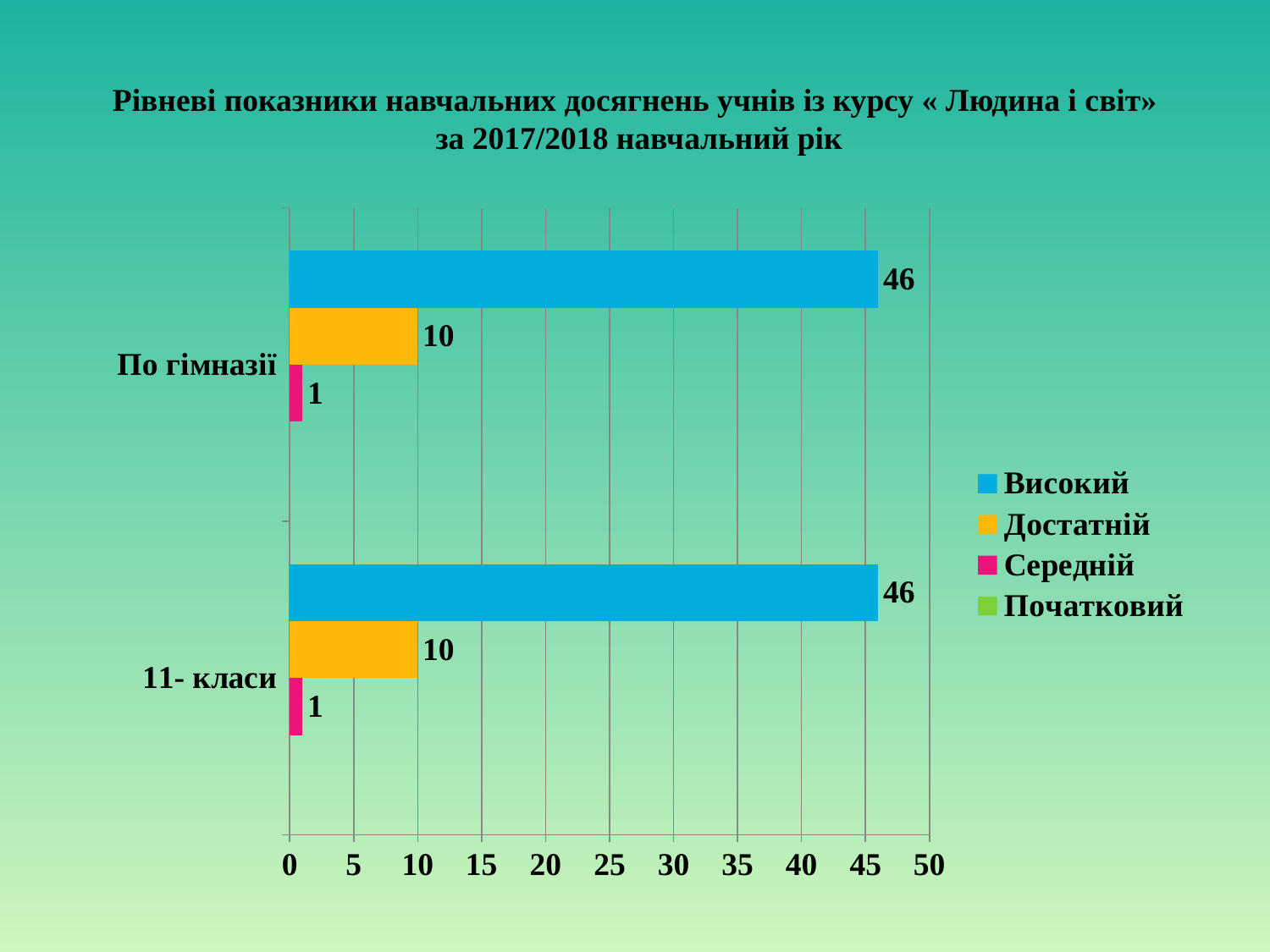
What is the difference between the Високий and Достатній values in the По гімназії category? 36 Which is larger in the 11- класи category: Високий or Достатній? Високий How many categories are shown on the vertical axis? 2 What is the value for Середній in the 11- класи category? 1 What colour are the Високий bars? Blue How many series does the legend list? 4 Which series with a visible bar has the lowest value in the 11- класи category? Середній What kind of chart is shown on the slide? Bar chart What is the difference between the Достатній and Середній values in the 11- класи category? 9 What is the value for Високий in the 11- класи category? 46 What is the value for Достатній in the По гімназії category? 10 Which series has the highest value in the По гімназії category? Високий